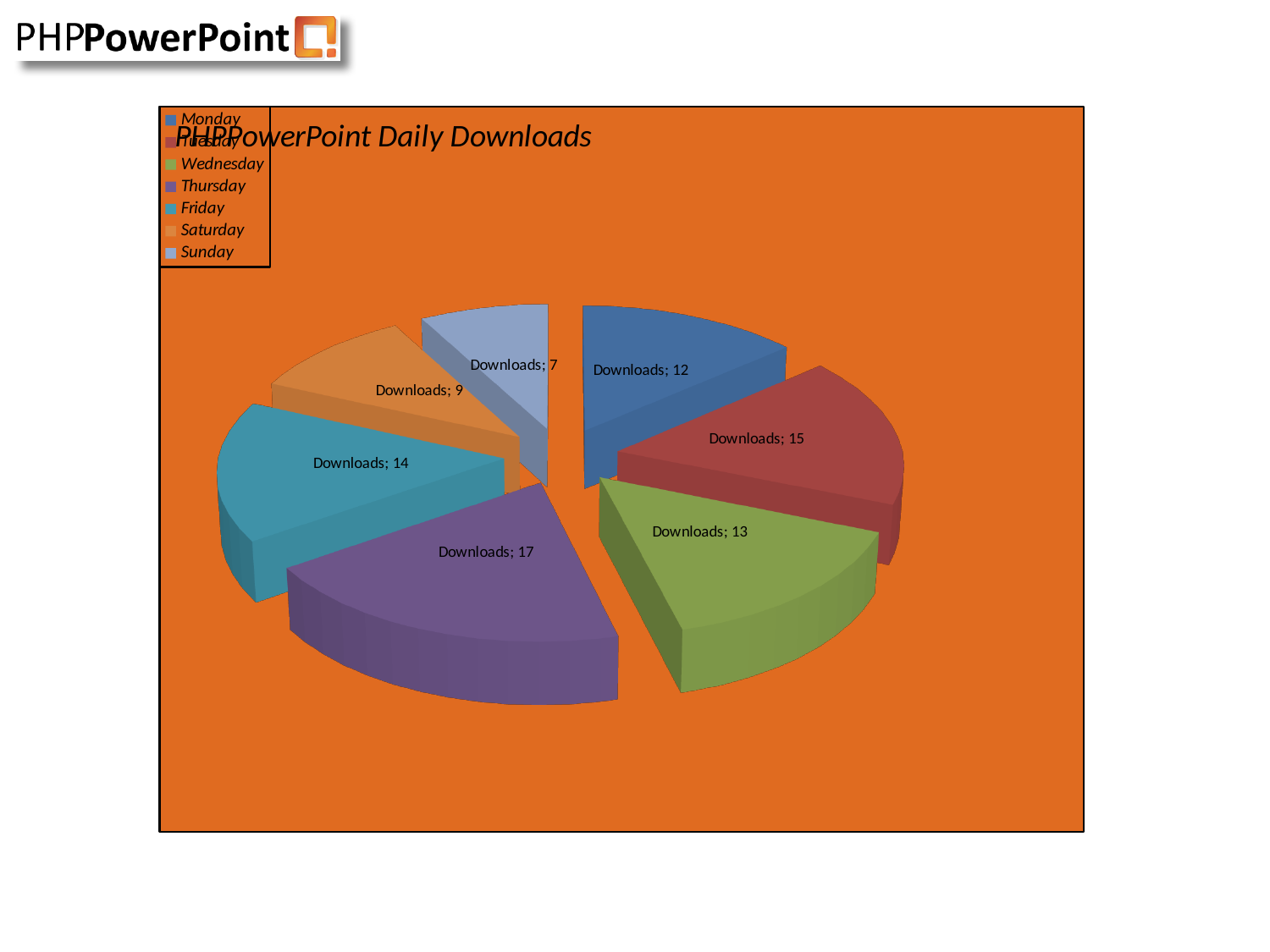
What is the total number of downloads across all seven days? 87 Which day has the highest number of downloads? Thursday What is the number of downloads for Tuesday? 15 What is the difference in downloads between Thursday and Sunday? 10 What is the number of downloads for Sunday? 7 How many slices does the pie chart have? 7 What is the number of downloads for Thursday? 17 Which has more downloads, Monday or Friday? Friday What is the number of downloads for Saturday? 9 What type of chart is shown on the slide? pie chart What is the title of the chart? PHPPowerPoint Daily Downloads Which day has the lowest number of downloads? Sunday